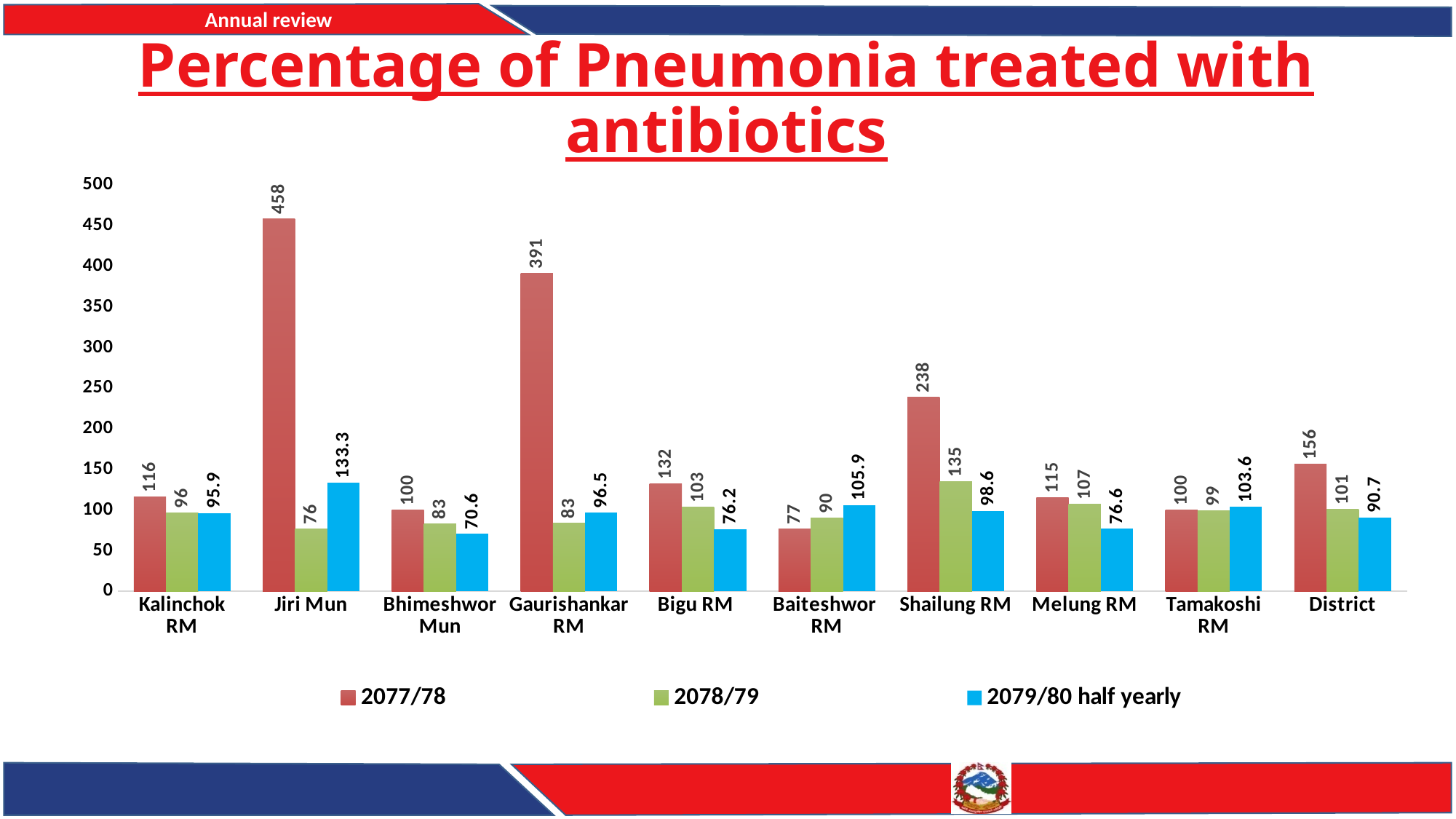
What is the title of the chart? Percentage of Pneumonia treated with antibiotics Which is larger for Melung RM: the 2078/79 value or the 2079/80 half yearly value? 2078/79 Which category has the highest value in the 2077/78 series? Jiri Mun What is the difference between the 2077/78 and 2078/79 values for Gaurishankar RM? 308 What is the value for Jiri Mun in the 2077/78 series? 458 What is the value for Shailung RM in the 2078/79 series? 135 How many categories are shown on the x axis? 10 How many series does the legend list? 3 What is the value for Baiteshwor RM in the 2079/80 half yearly series? 105.9 Which category has the lowest value in the 2079/80 half yearly series? Bhimeshwor Mun What kind of chart is shown on the slide? Bar chart Is the 2077/78 value for Shailung RM greater or less than 200? greater